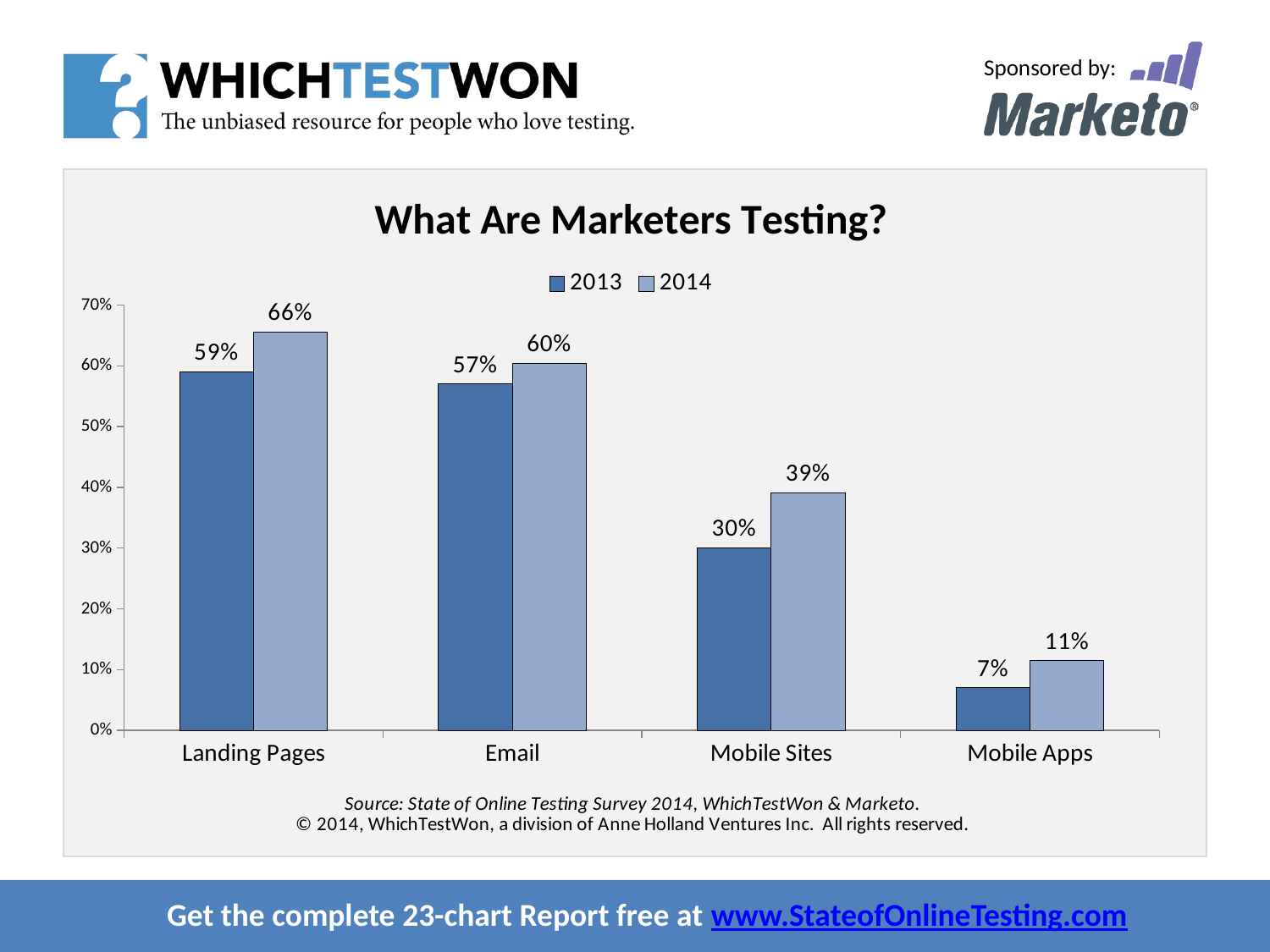
Which category has the highest 2014 value? Landing Pages What is the 2013 value for Mobile Sites? 30% What is the difference between the 2014 and 2013 values for Mobile Sites? 9% What is the difference between the 2013 values for Landing Pages and Email? 2% Which category has the lowest 2013 value? Mobile Apps What kind of chart is shown? Bar chart What is the 2013 value for Mobile Apps? 7% What is the 2014 value for Landing Pages? 66% How many series does the legend list? 2 What is the title of the chart? What Are Marketers Testing? How many categories are shown on the x axis? 4 Which is larger, the 2014 value for Email or the 2014 value for Mobile Sites? Email